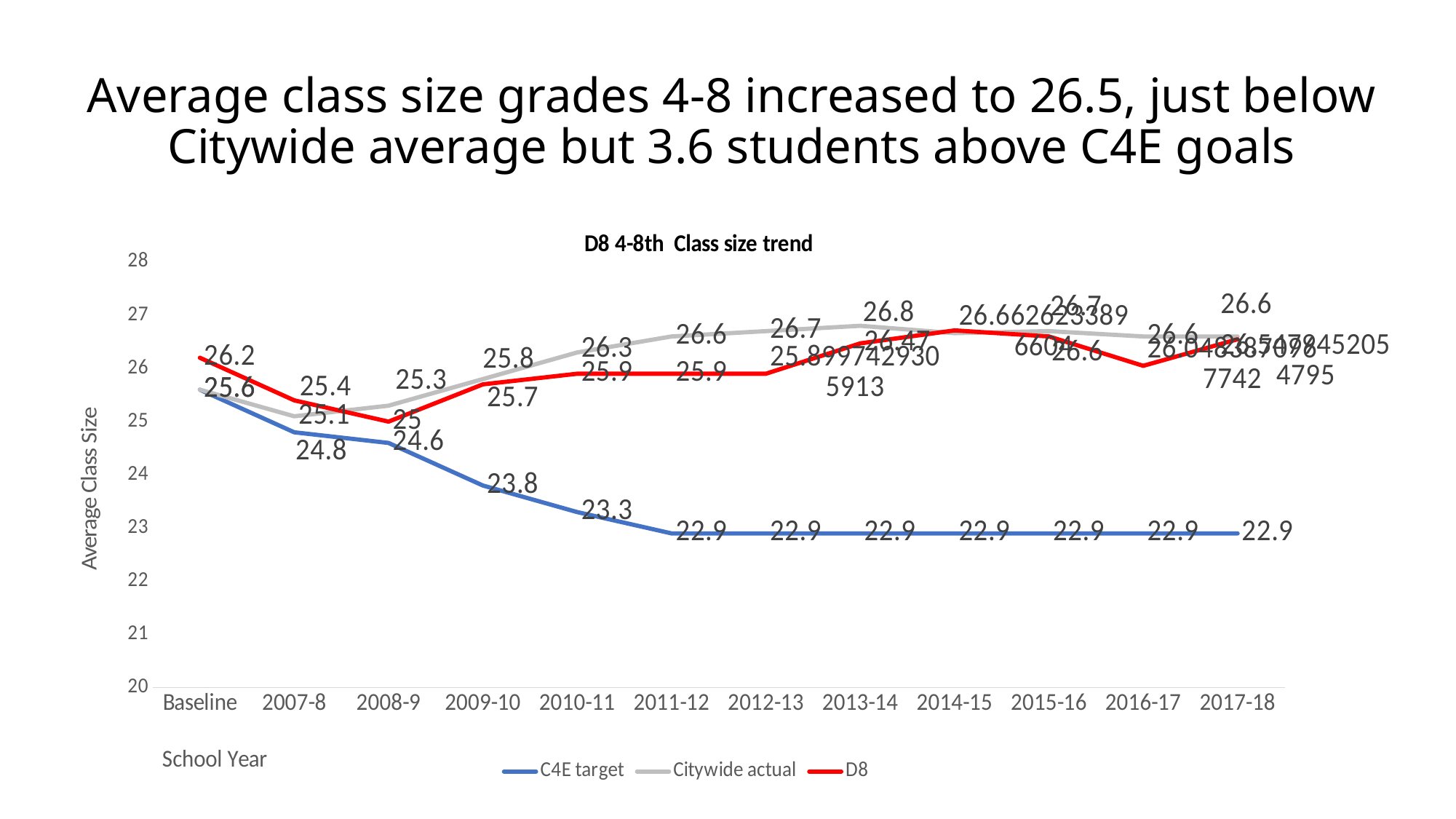
How many series does the legend of the chart list? 3 Is the C4E target value for 2017-18 greater or less than 23? less How many school years (categories) are shown on the x axis of the chart? 12 What kind of chart is shown on the slide? line chart What is the Citywide actual value for 2013-14? 26.8 What is the D8 value at Baseline? 26.2 Does the C4E target line rise or fall from Baseline to 2011-12? fall What is the title of the vertical axis of the chart? Average Class Size What is the difference between the C4E target at Baseline and the C4E target in 2017-18? 2.7 In 2011-12, which is larger: the Citywide actual value or the D8 value? Citywide actual What is the C4E target value for 2010-11? 23.3 What is the C4E target value for 2009-10? 23.8